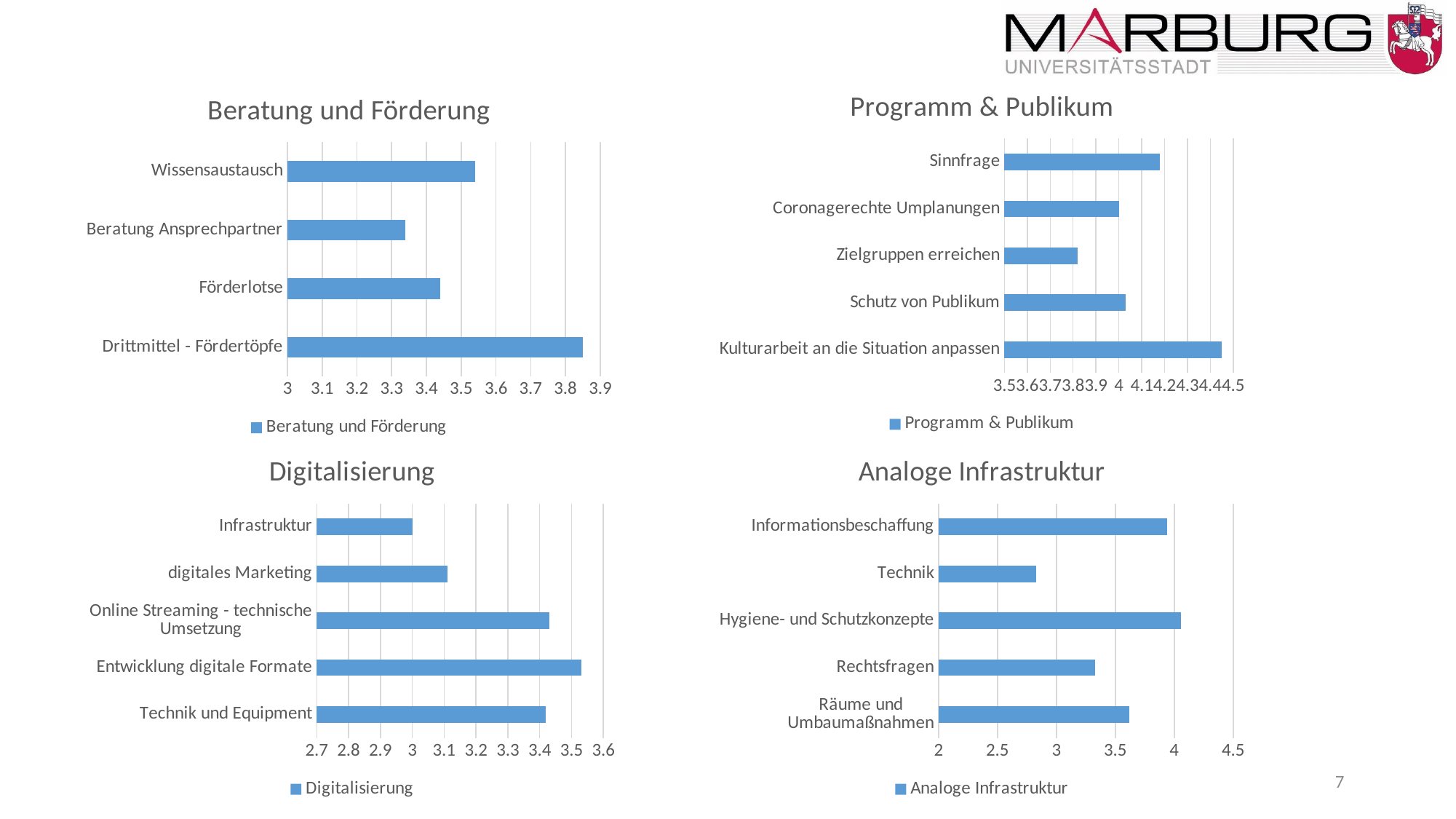
What kind of chart is the 'Analoge Infrastruktur' chart? bar chart In the 'Beratung und Förderung' chart, which category has the highest value? Drittmittel - Fördertöpfe How many categories are shown in the 'Programm & Publikum' chart? 5 In the 'Beratung und Förderung' chart, is the value for Drittmittel - Fördertöpfe greater or less than 3.7? greater In the 'Analoge Infrastruktur' chart, is the value for Technik greater or less than 3? less In the 'Digitalisierung' chart, which category has the highest value? Entwicklung digitale Formate In the 'Digitalisierung' chart, which is larger: Infrastruktur or digitales Marketing? digitales Marketing In the 'Programm & Publikum' chart, which category has the lowest value? Zielgruppen erreichen In the 'Analoge Infrastruktur' chart, which category has the lowest value? Technik In the 'Beratung und Förderung' chart, which category has the lowest value? Beratung Ansprechpartner In the 'Programm & Publikum' chart, is the value for Zielgruppen erreichen greater or less than 4? less In the 'Programm & Publikum' chart, which category has the highest value? Kulturarbeit an die Situation anpassen